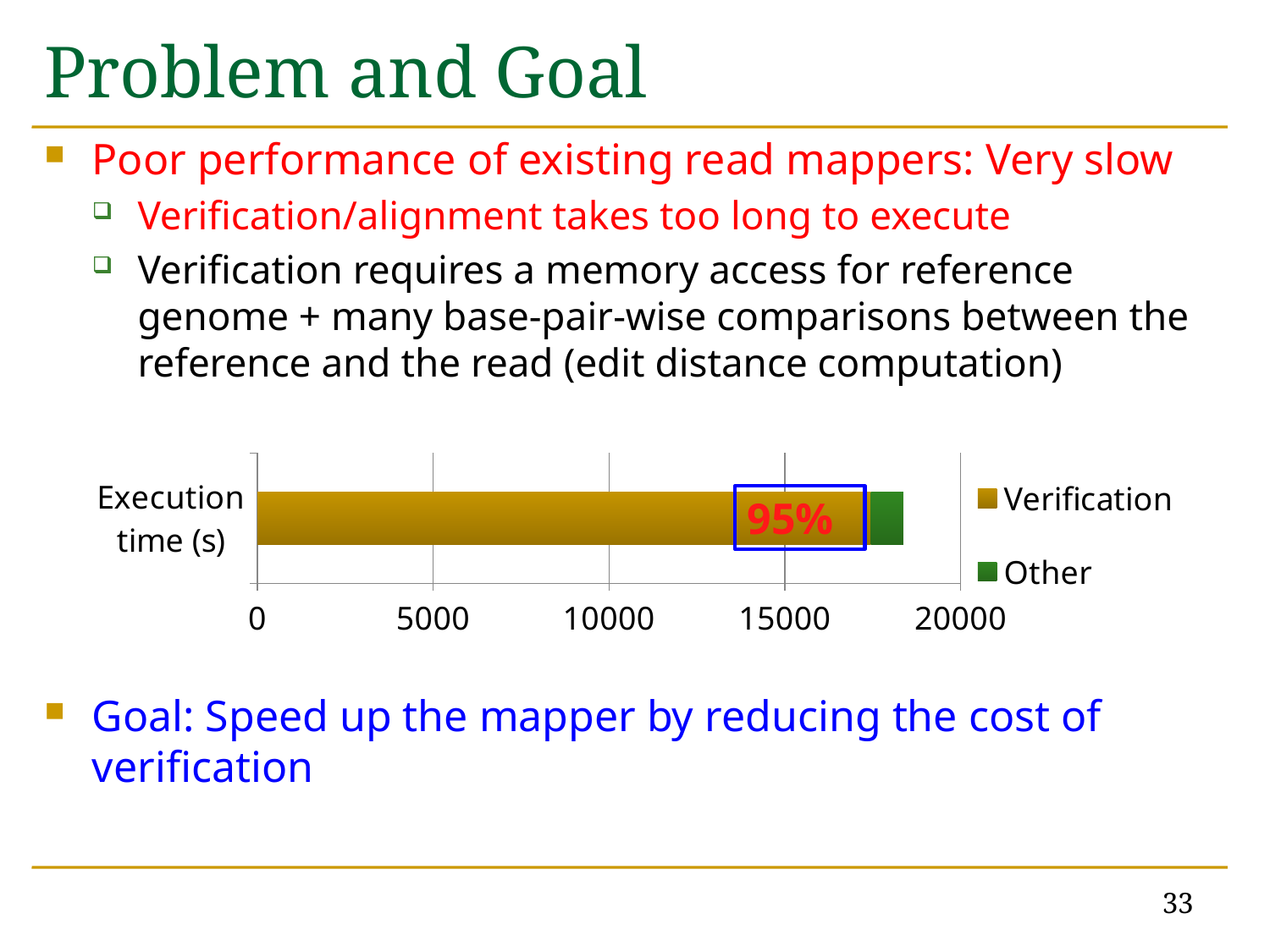
Is the Other segment of the execution time bar greater or less than 5000? less What percentage of execution time is annotated on the Verification segment of the bar? 95% Is the Verification segment of the execution time bar greater or less than 15000? greater What is the label of the single category on the chart? Execution time (s) Is the total length of the stacked execution time bar greater or less than 20000? less Which series takes up the larger part of the execution time bar, Verification or Other? Verification How many categories are plotted on the chart's vertical axis? 1 What are the two series named in the chart legend? Verification and Other How many series does the chart legend list? 2 What is the highest value shown on the chart's horizontal axis? 20000 Which series has the smallest share of the execution time bar? Other What kind of chart is shown on the slide? bar chart